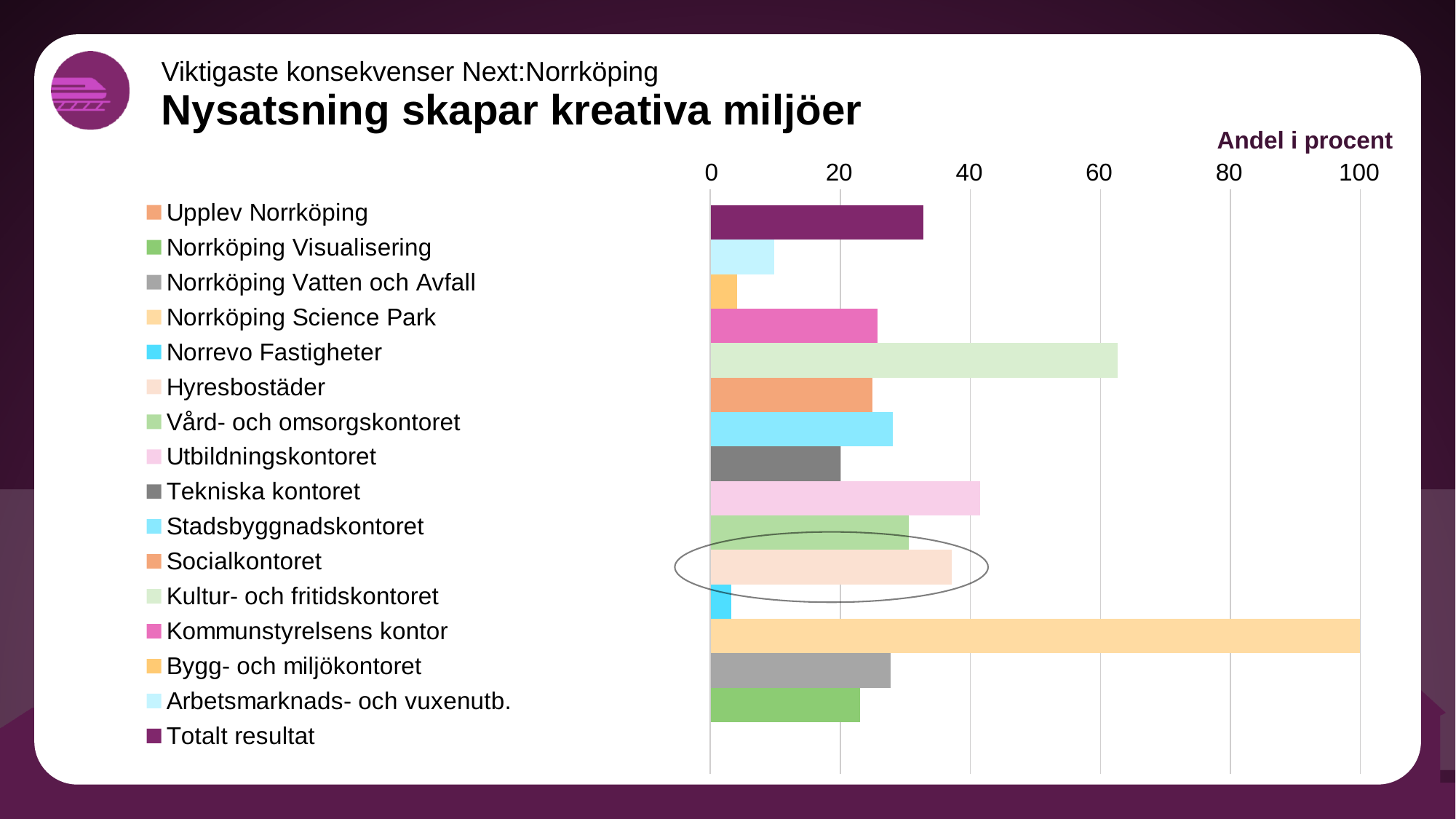
What kind of chart is shown on the slide? bar chart What label is shown above the horizontal axis of the chart? Andel i procent How many entries does the legend list? 16 Which category has the highest value in the chart? Norrköping Science Park Is the value for Kultur- och fritidskontoret greater or less than 60? greater What is the value for Norrköping Science Park? 100 Is the value for Totalt resultat greater or less than 40? less Is the value for Arbetsmarknads- och vuxenutb. greater or less than 20? less Which is larger, the value for Hyresbostäder or the value for Tekniska kontoret? Hyresbostäder Which is larger, the value for Kultur- och fritidskontoret or the value for Totalt resultat? Kultur- och fritidskontoret Which category's bar is circled in the chart? Hyresbostäder